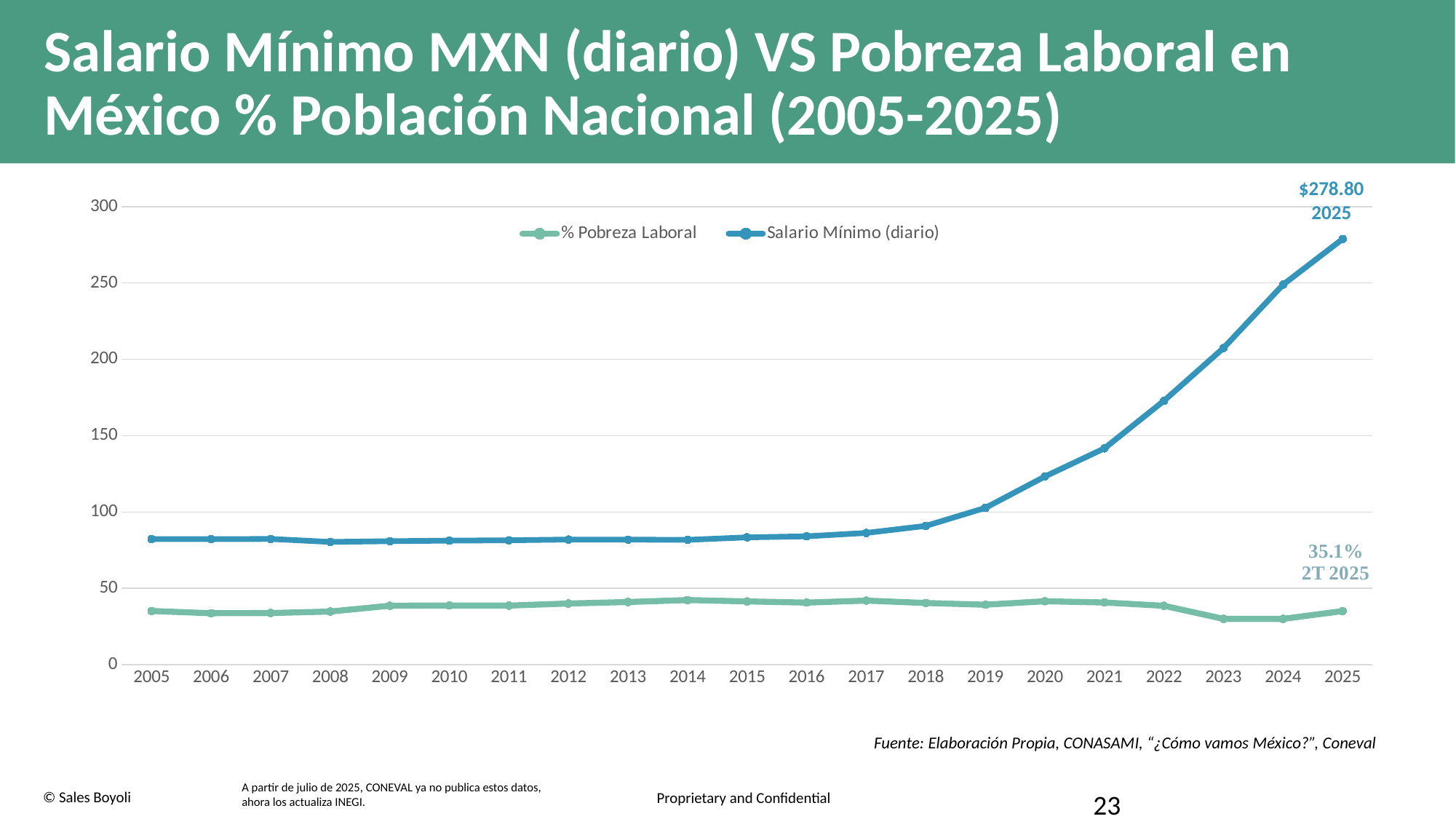
Is the value of Salario Mínimo (diario) for 2018 greater or less than 100? less What is the value of Salario Mínimo (diario) for 2025? $278.80 In which year is the Salario Mínimo (diario) series at its highest? 2025 Which series is shown in blue in the legend? Salario Mínimo (diario) Is the value of Salario Mínimo (diario) for 2022 greater or less than 150? greater How many series does the legend list? 2 Is the value of % Pobreza Laboral for 2023 greater or less than 50? less What kind of chart is shown on the slide? line chart What is the value of % Pobreza Laboral labelled for 2T 2025? 35.1% How many years are shown on the x axis? 21 Does the Salario Mínimo (diario) series rise or fall from 2018 to 2025? rise